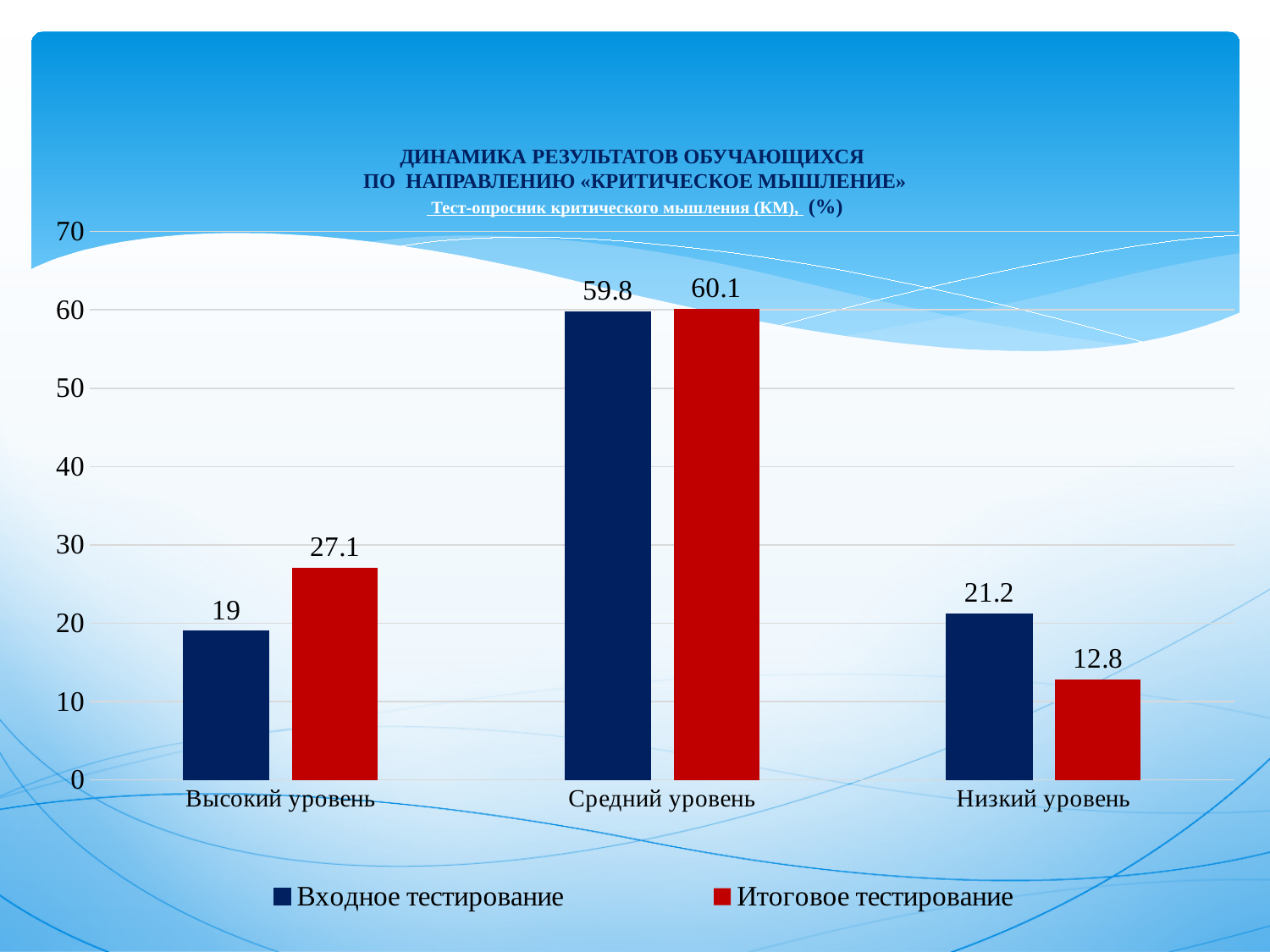
What is the difference between Итоговое тестирование and Входное тестирование at Высокий уровень? 8.1 How many series does the legend list? 2 At Высокий уровень, which is larger: Входное тестирование or Итоговое тестирование? Итоговое тестирование Is the value for Входное тестирование at Низкий уровень greater or less than 20? greater What is the value for Входное тестирование at Высокий уровень? 19 What kind of chart is shown on the slide? bar chart What is the value for Итоговое тестирование at Средний уровень? 60.1 What is the difference between Входное тестирование and Итоговое тестирование at Низкий уровень? 8.4 Which category has the lowest value for Итоговое тестирование? Низкий уровень How many categories are shown on the x axis? 3 Which category has the highest value for Входное тестирование? Средний уровень What is the value for Итоговое тестирование at Низкий уровень? 12.8